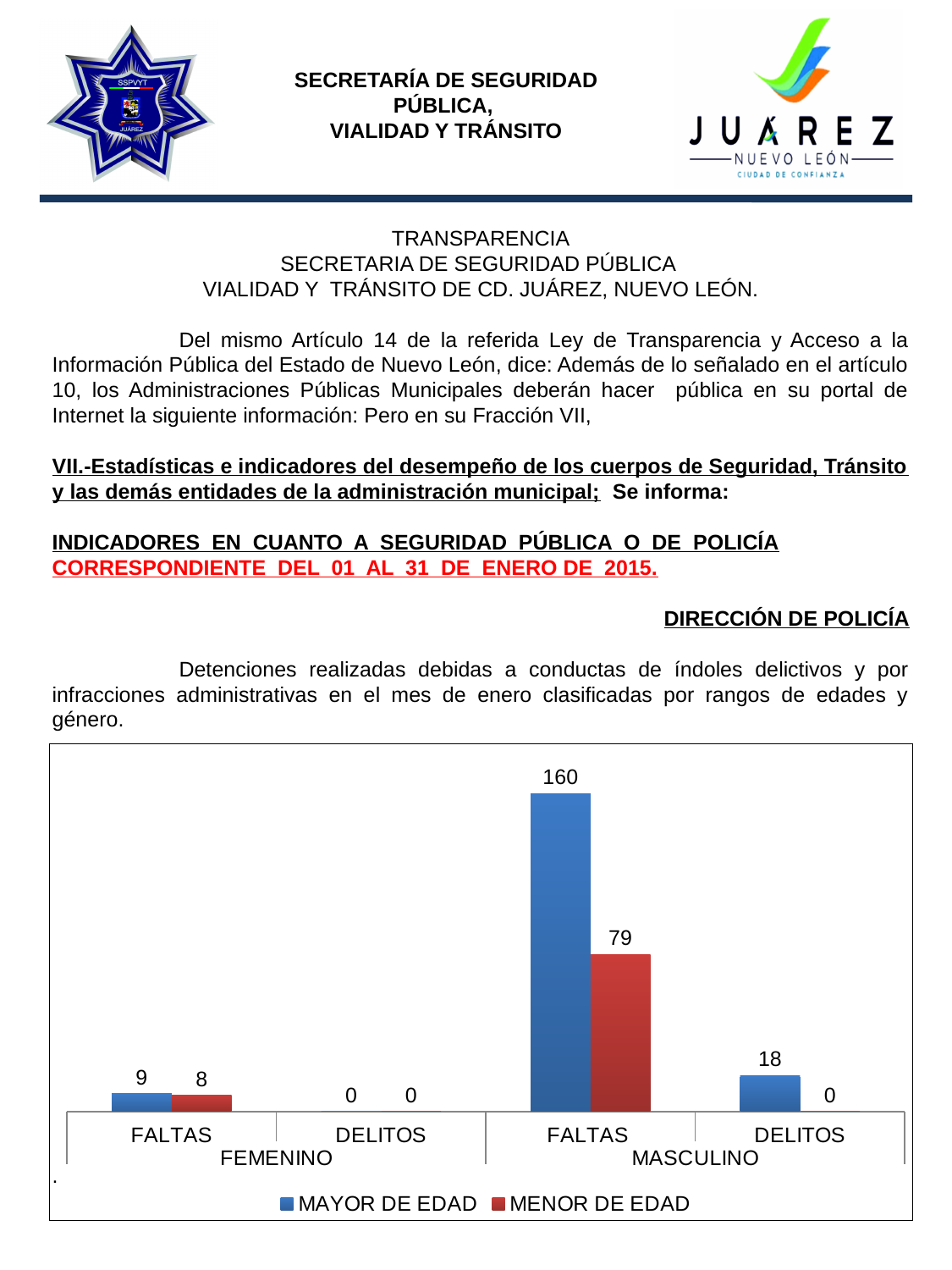
What is the difference between MAYOR DE EDAD and MENOR DE EDAD in the MASCULINO FALTAS category? 81 What is the value for MENOR DE EDAD in the FEMENINO DELITOS category? 0 What is the value for MENOR DE EDAD in the MASCULINO FALTAS category? 79 What is the value for MENOR DE EDAD in the FEMENINO FALTAS category? 8 What is the value for MAYOR DE EDAD in the MASCULINO DELITOS category? 18 How many series does the legend list? 2 What is the value for MAYOR DE EDAD in the MASCULINO FALTAS category? 160 What kind of chart is shown on the slide? Bar chart Which category has the highest value for MAYOR DE EDAD? MASCULINO FALTAS Which is larger in the FEMENINO FALTAS category, MAYOR DE EDAD or MENOR DE EDAD? MAYOR DE EDAD What colour represents the MENOR DE EDAD series? Red What is the value for MAYOR DE EDAD in the FEMENINO FALTAS category? 9